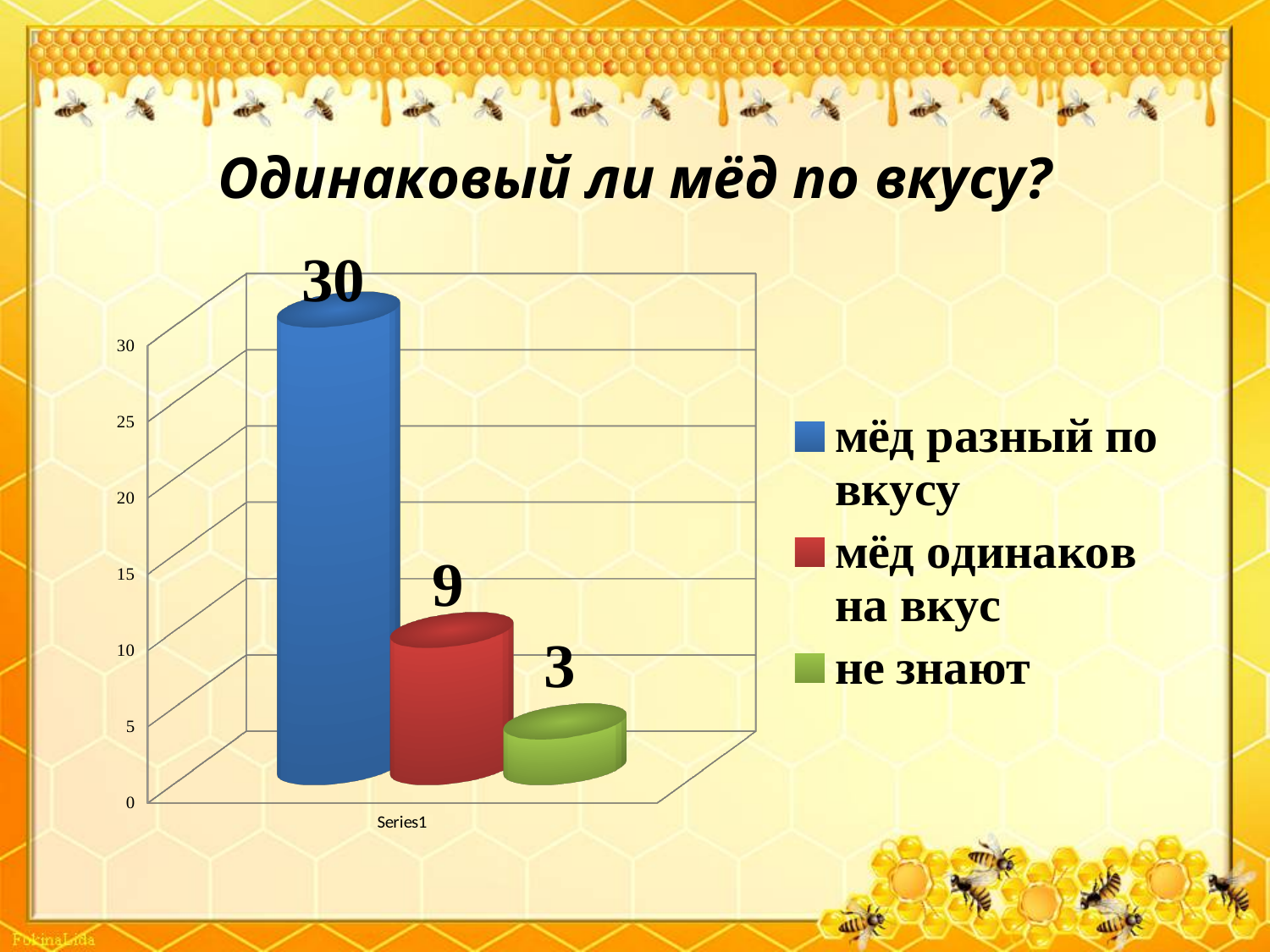
What is the difference between the values for "мёд разный по вкусу" and "мёд одинаков на вкус"? 21 How many categories does the legend list? 3 What kind of chart is shown on the slide? bar chart Is the value for "мёд разный по вкусу" greater or less than 25? greater Which category has the lowest value? не знают What is the title of the slide above the chart? Одинаковый ли мёд по вкусу? Which category has the highest value? мёд разный по вкусу Which is larger: the value for "мёд одинаков на вкус" or the value for "не знают"? мёд одинаков на вкус What is the difference between the values for "мёд одинаков на вкус" and "не знают"? 6 What is the value for "мёд одинаков на вкус"? 9 What is the value for "мёд разный по вкусу"? 30 What is the value for "не знают"? 3